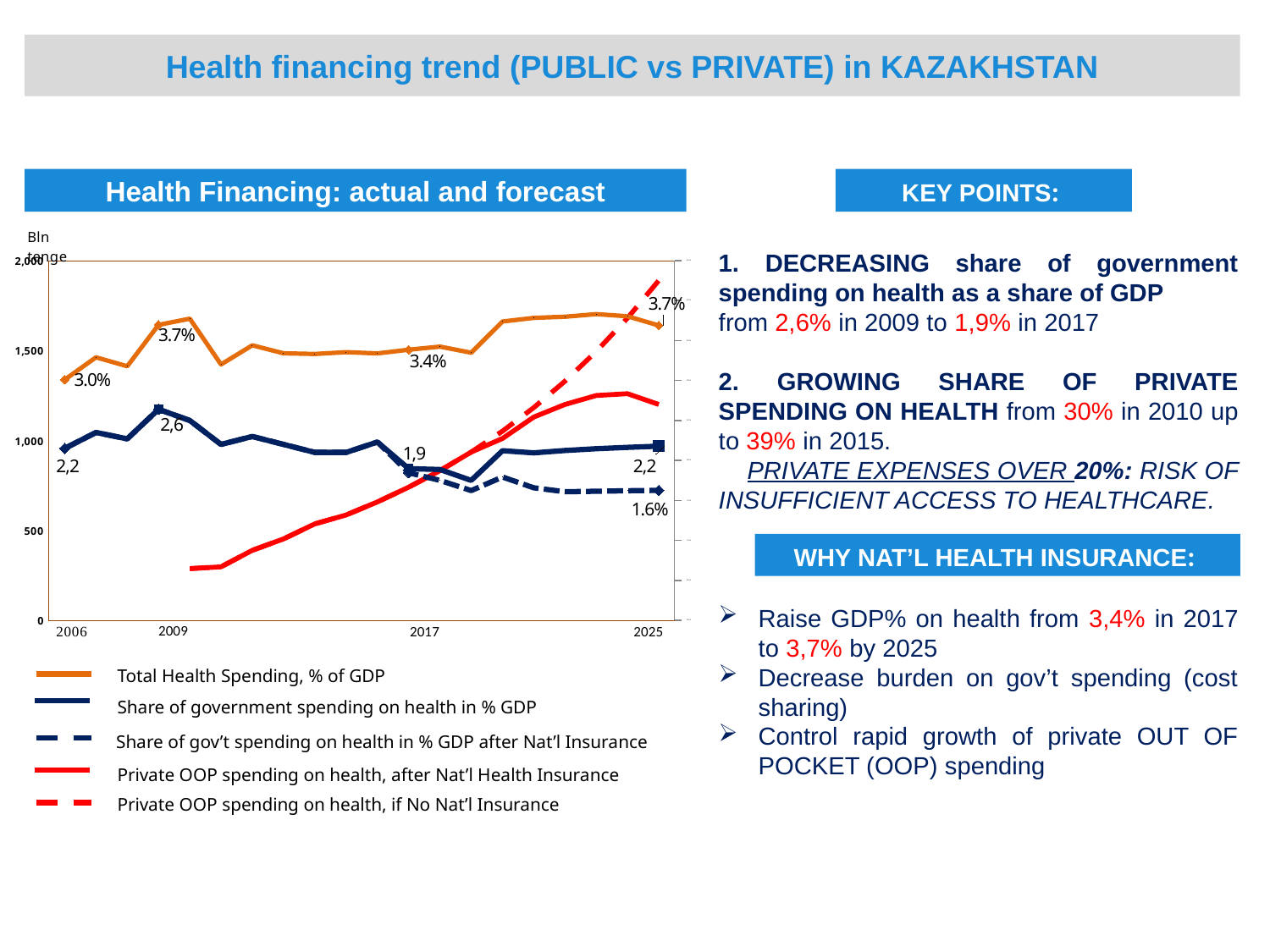
What is the labelled value of Total Health Spending, % of GDP in 2006? 3.0% What is the unit shown on the vertical axis of the 'Health Financing: actual and forecast' chart? Bln tenge Which series is drawn in orange in the 'Health Financing: actual and forecast' chart? Total Health Spending, % of GDP Which is larger: the share of government spending on health in 2009 or in 2017? 2009 What type of chart is shown under the title 'Health Financing: actual and forecast'? line chart What is the labelled value of Total Health Spending, % of GDP in 2017? 3.4% What is the labelled value of the share of government spending on health in % GDP in 2017? 1,9 What is the labelled value of Total Health Spending, % of GDP in 2025? 3.7% What is the labelled value of the share of gov't spending on health in % GDP after Nat'l Insurance in 2025? 1.6% How many series does the legend of the 'Health Financing: actual and forecast' chart list? 5 What is the labelled value of the share of government spending on health in % GDP in 2009? 2,6 Does the share of government spending on health in % GDP rise or fall between 2009 and 2017? fall